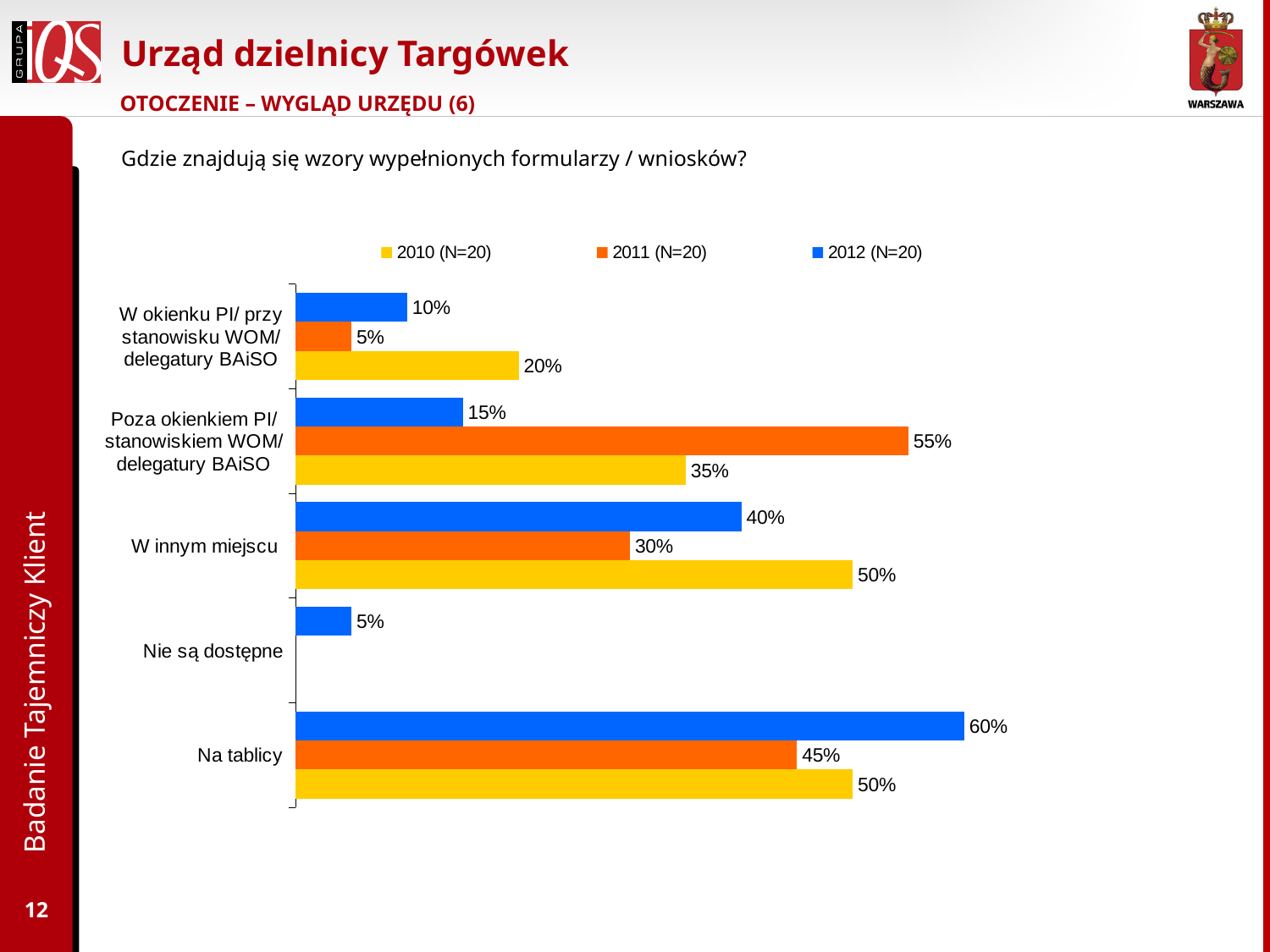
Which colour represents the 2011 (N=20) series in the legend? orange What kind of chart is shown on the slide? bar chart What is the value for 'W innym miejscu' in the 2010 (N=20) series? 50% How many series does the legend list? 3 What is the difference between the 2012 (N=20) and 2011 (N=20) values for 'Na tablicy'? 15% How many categories are shown on the chart? 5 What is the value for 'Na tablicy' in the 2012 (N=20) series? 60% Which is larger for 'W innym miejscu': the 2012 (N=20) value or the 2011 (N=20) value? 2012 (N=20) Which category has the highest value in the 2012 (N=20) series? Na tablicy What is the value for 'Poza okienkiem PI/ stanowiskiem WOM/ delegatury BAiSO' in the 2011 (N=20) series? 55% What is the value for 'Nie są dostępne' in the 2012 (N=20) series? 5% Which category has the lowest value in the 2010 (N=20) series among those with a bar shown? W okienku PI/ przy stanowisku WOM/ delegatury BAiSO